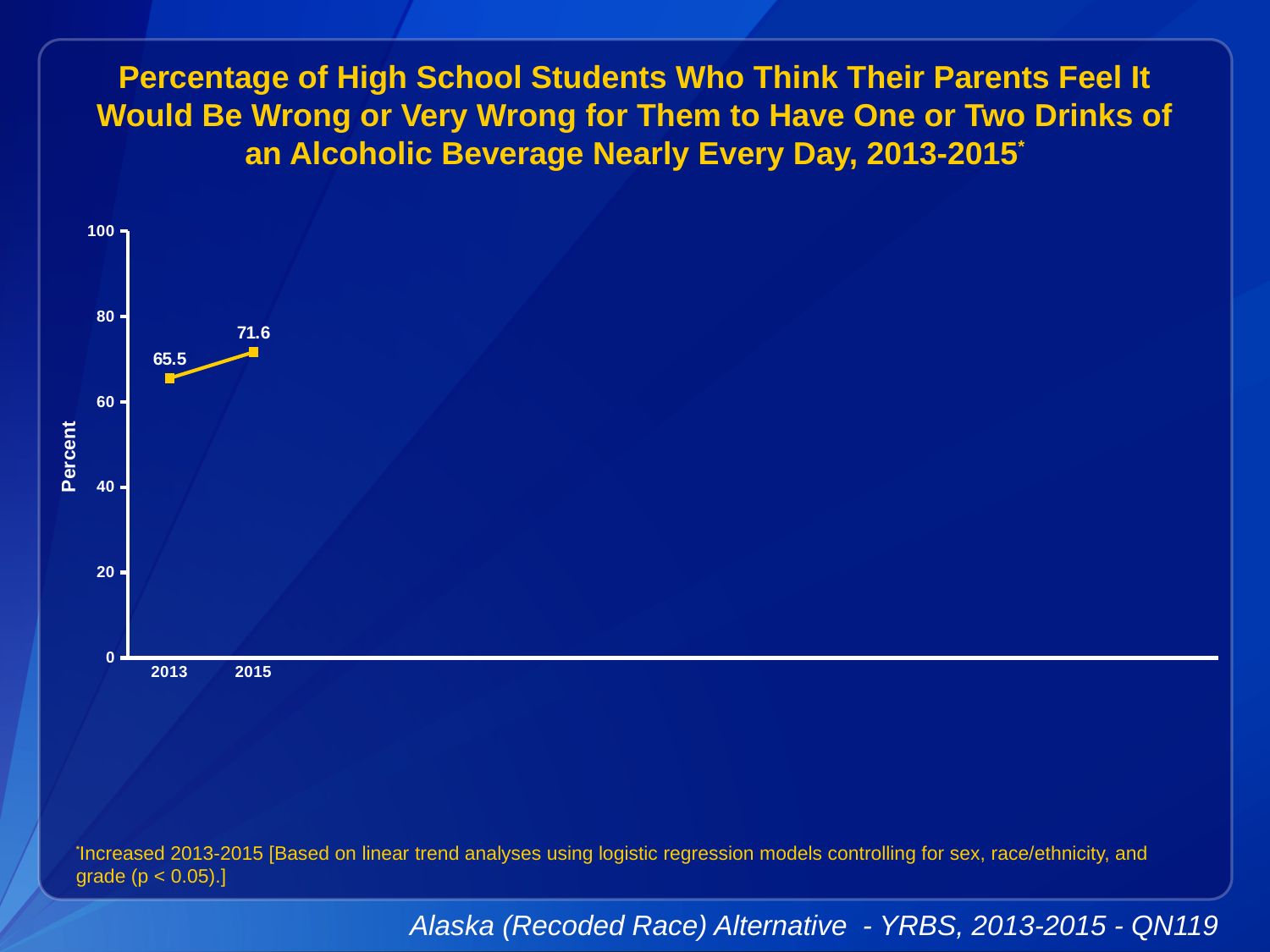
Which year has the higher value? 2015 What is the value for 2015? 71.6 Which year has the lower value? 2013 What is the value for 2013? 65.5 Is the value for 2015 larger than the value for 2013? Yes What is the label on the vertical axis? Percent What is the difference between the 2015 and 2013 values? 6.1 Is the value for 2013 greater or less than 80? less Do the values rise or fall from 2013 to 2015? Rise Is the value for 2015 greater or less than 60? greater What kind of chart is shown on the slide? Line chart How many data points are plotted on the chart? 2